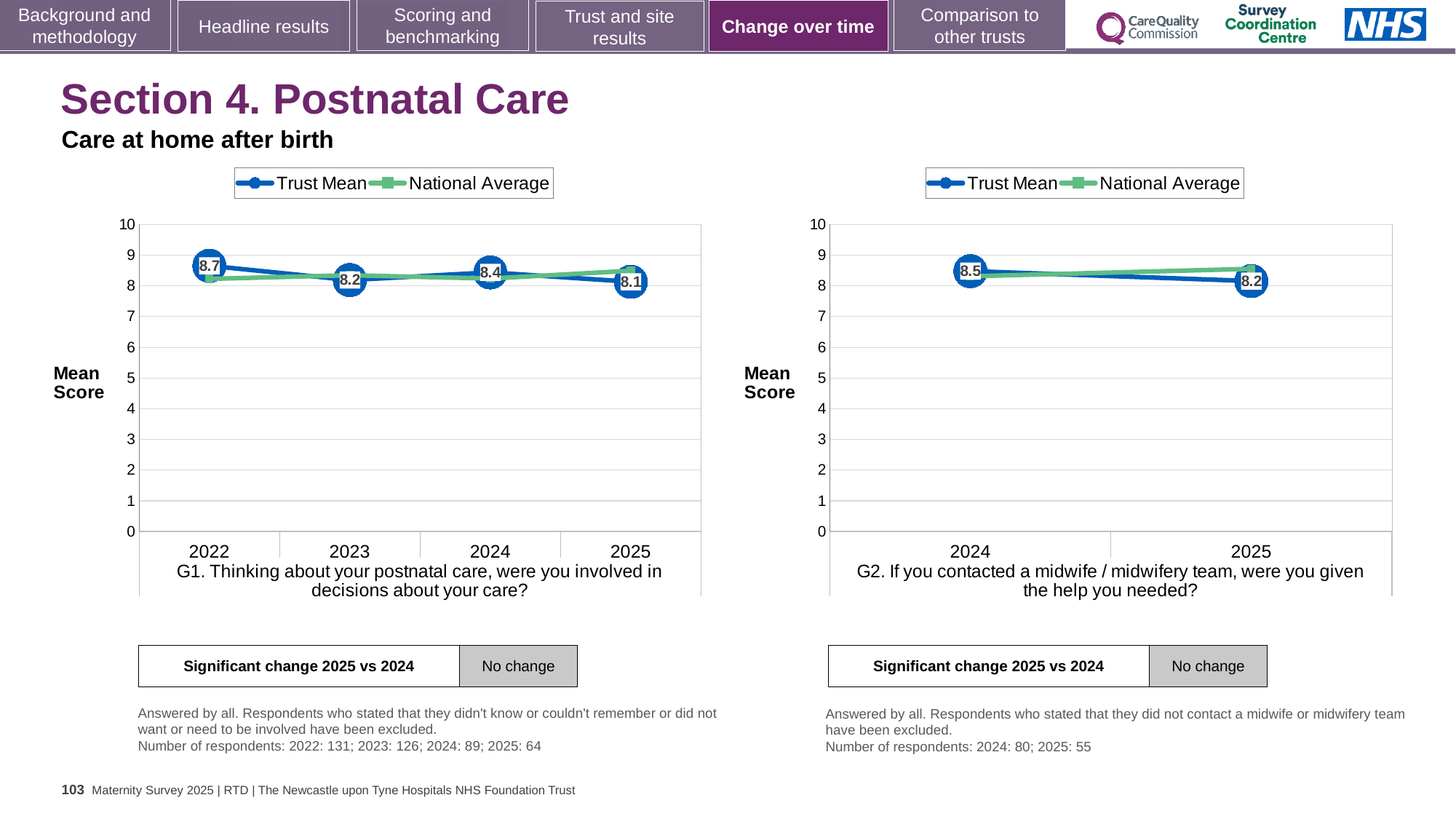
In the G2 chart, what is the difference between the Trust Mean for 2024 and 2025? 0.3 In the G1 chart, what is the Trust Mean for 2022? 8.7 In the G1 chart, which year has the highest Trust Mean? 2022 How many years are shown on the x axis of the G1 chart? 4 In the G2 chart, what is the Trust Mean for 2024? 8.5 In the G2 chart, is the National Average for 2025 greater or less than 7? greater What kind of chart is the G2 chart? Line chart How many series does the legend of the G2 chart list? 2 In the G1 chart, what is the Trust Mean for 2025? 8.1 In the G1 chart, what is the difference between the Trust Mean for 2022 and 2025? 0.6 In the G1 chart, which year has the lowest Trust Mean? 2025 In the G1 chart, is the Trust Mean higher in 2023 or 2024? 2024